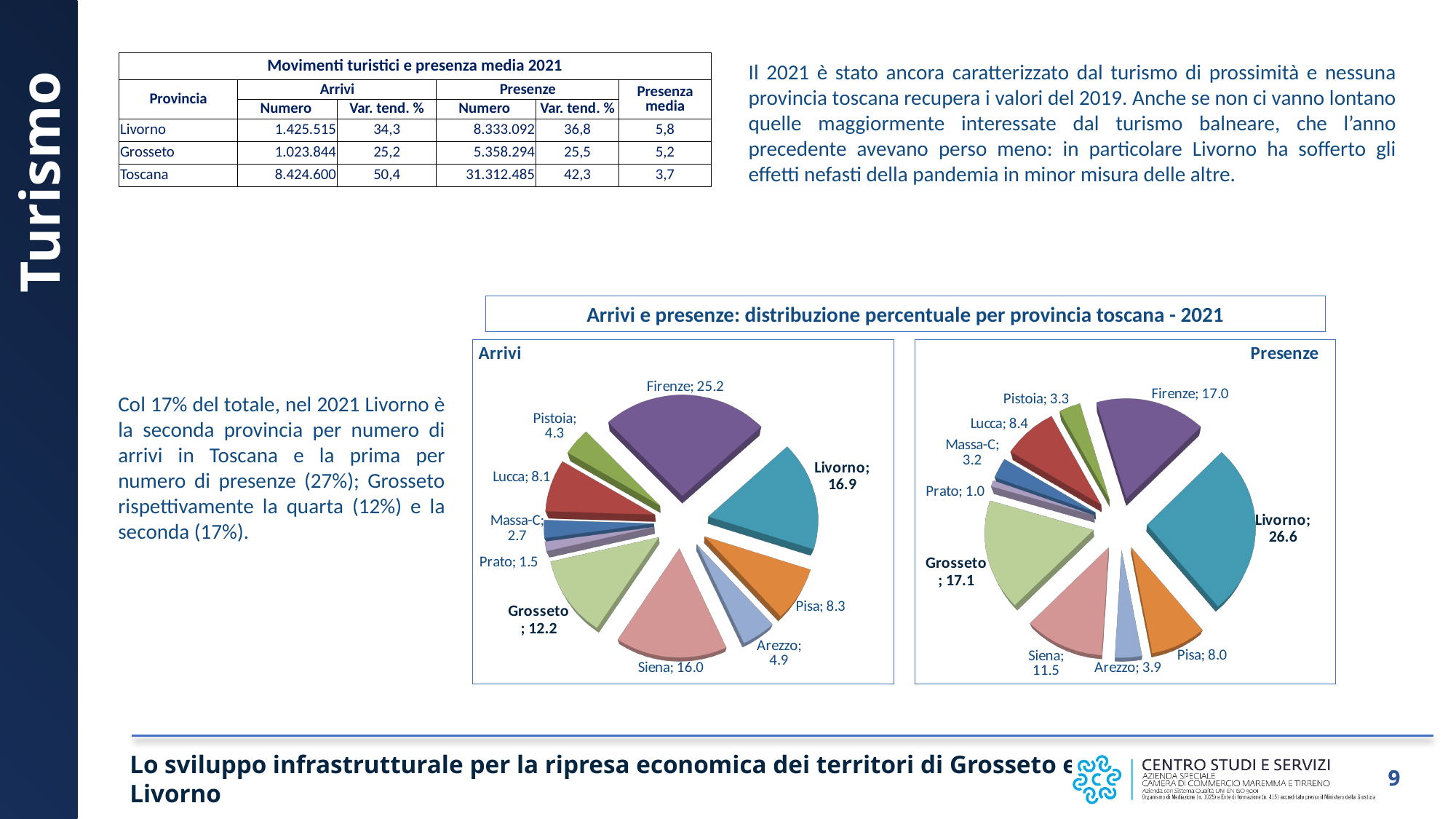
What is the title shown above the two pie charts? Arrivi e presenze: distribuzione percentuale per provincia toscana - 2021 In the Arrivi pie chart, which province has the largest slice? Firenze What kind of chart is the Arrivi chart? Pie chart In the Presenze pie chart, what is the difference between the values for Livorno and Siena? 15.1 In the Arrivi pie chart, which is larger, the value for Siena or the value for Grosseto? Siena In the Presenze pie chart, which province has the largest slice? Livorno In the Arrivi pie chart, what is the difference between the values for Firenze and Livorno? 8.3 In the Presenze pie chart, what is the value for Grosseto? 17.1 How many provinces are shown in the Presenze pie chart? 10 In the Arrivi pie chart, what is the value for Livorno? 16.9 In the Presenze pie chart, which province has the smallest slice? Prato In the Arrivi pie chart, which province has the smallest slice? Prato